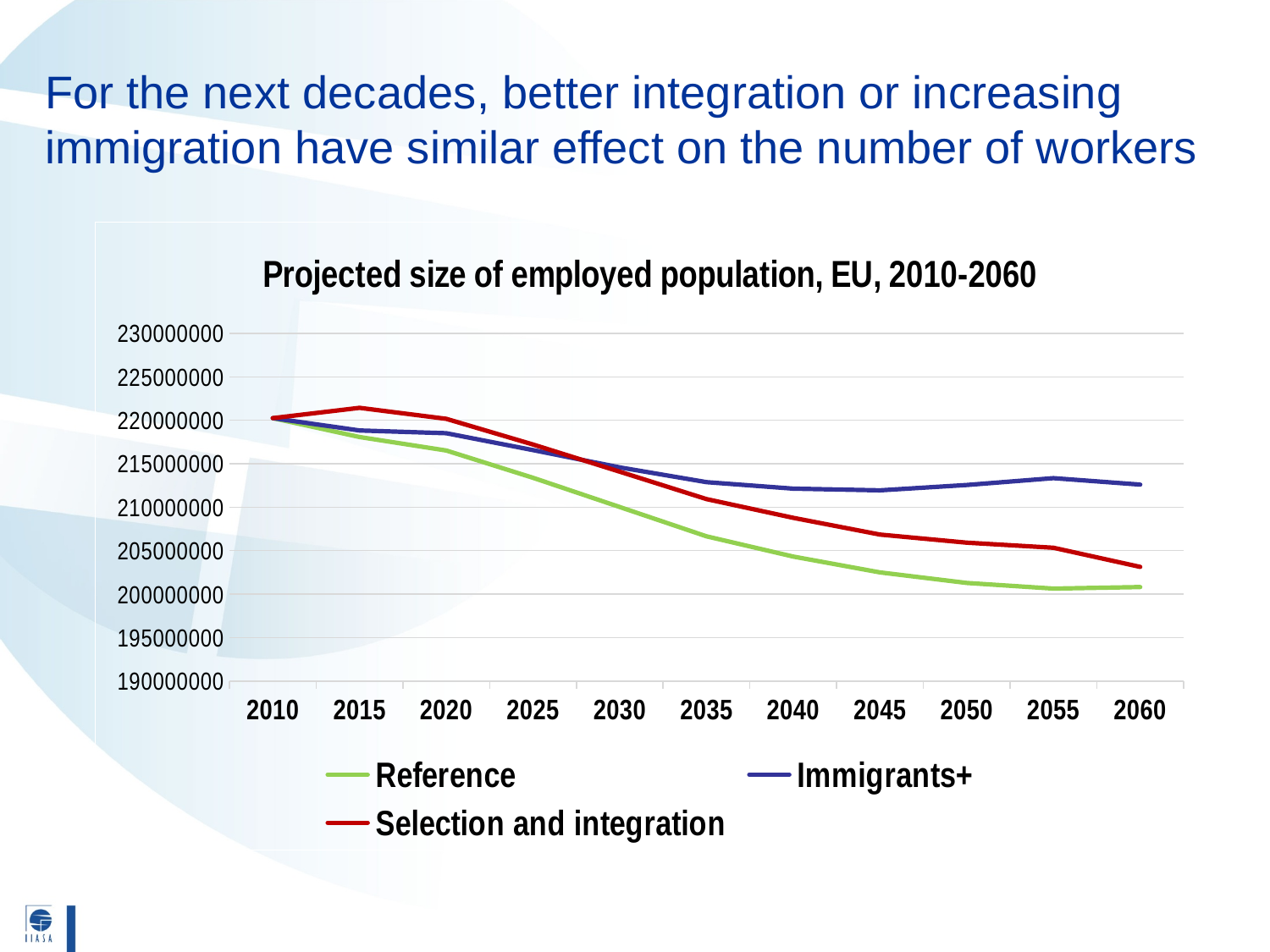
What is the title of the chart? Projected size of employed population, EU, 2010-2060 Is the value for Immigrants+ in 2060 greater or less than 210000000? greater Does the Reference series rise or fall from 2010 to 2060? fall Is the value for Reference in 2060 greater or less than 205000000? less Is the value for Reference in 2040 greater or less than 210000000? less What kind of chart is shown on the slide? line chart In 2015, which is larger: Selection and integration or Reference? Selection and integration How many years are marked along the x axis? 11 Which series has the highest value in 2060? Immigrants+ How many series does the legend list? 3 Which series has the lowest value in 2060? Reference